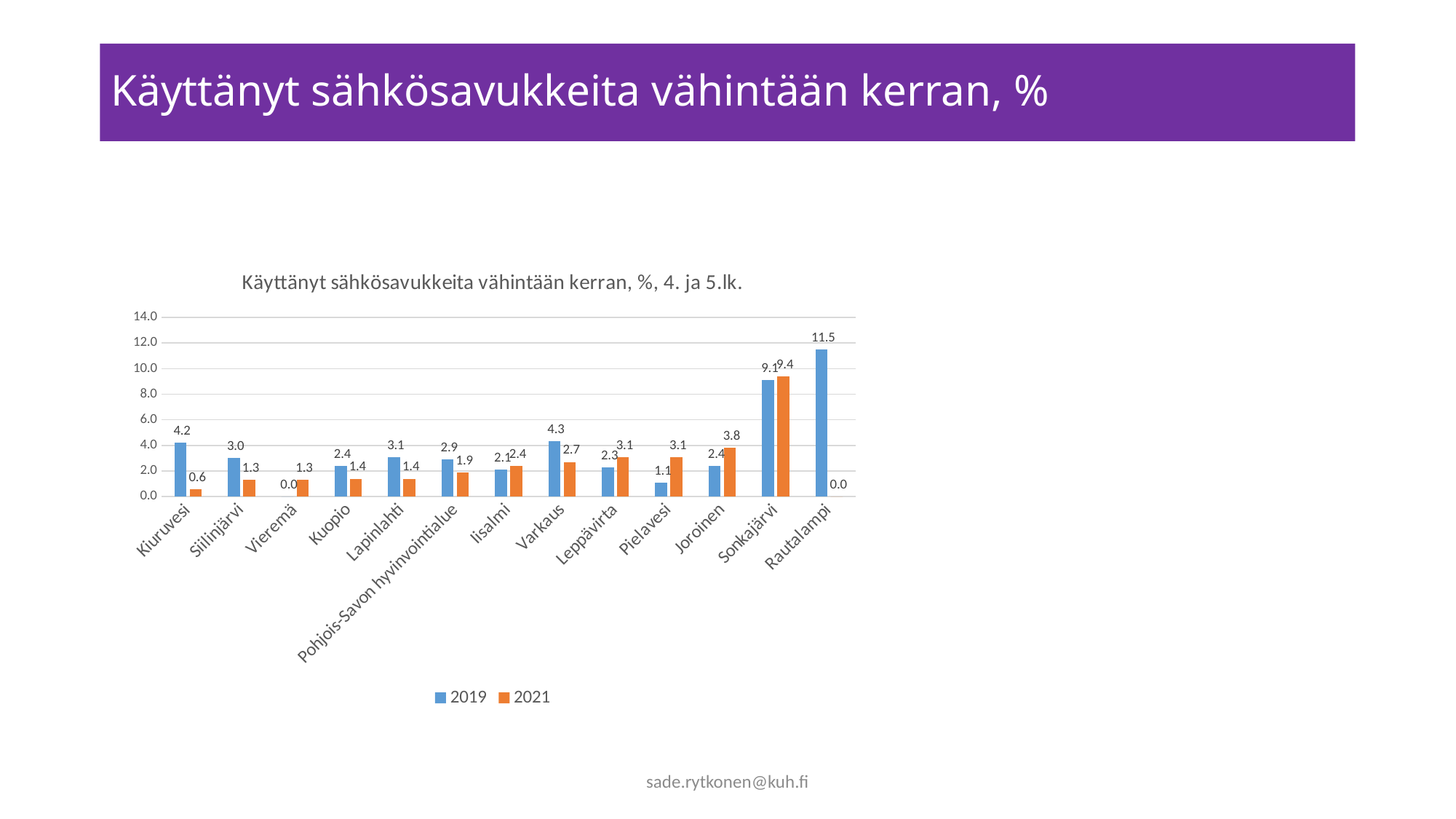
What is the difference between the 2019 and 2021 values for Varkaus? 1.6 Is the 2019 value for Sonkajärvi greater or less than 8.0? greater Which category has the lowest 2021 value? Rautalampi Which is larger for Pielavesi, the 2019 value or the 2021 value? 2021 What is the 2021 value for Pohjois-Savon hyvinvointialue? 1.9 How many categories are shown on the x axis? 13 What is the 2019 value for Kiuruvesi? 4.2 What is the 2021 value for Joroinen? 3.8 Which colour represents the 2021 series in the chart? orange Which category has the highest 2019 value? Rautalampi How many series does the legend list? 2 What type of chart is shown on the slide? bar chart